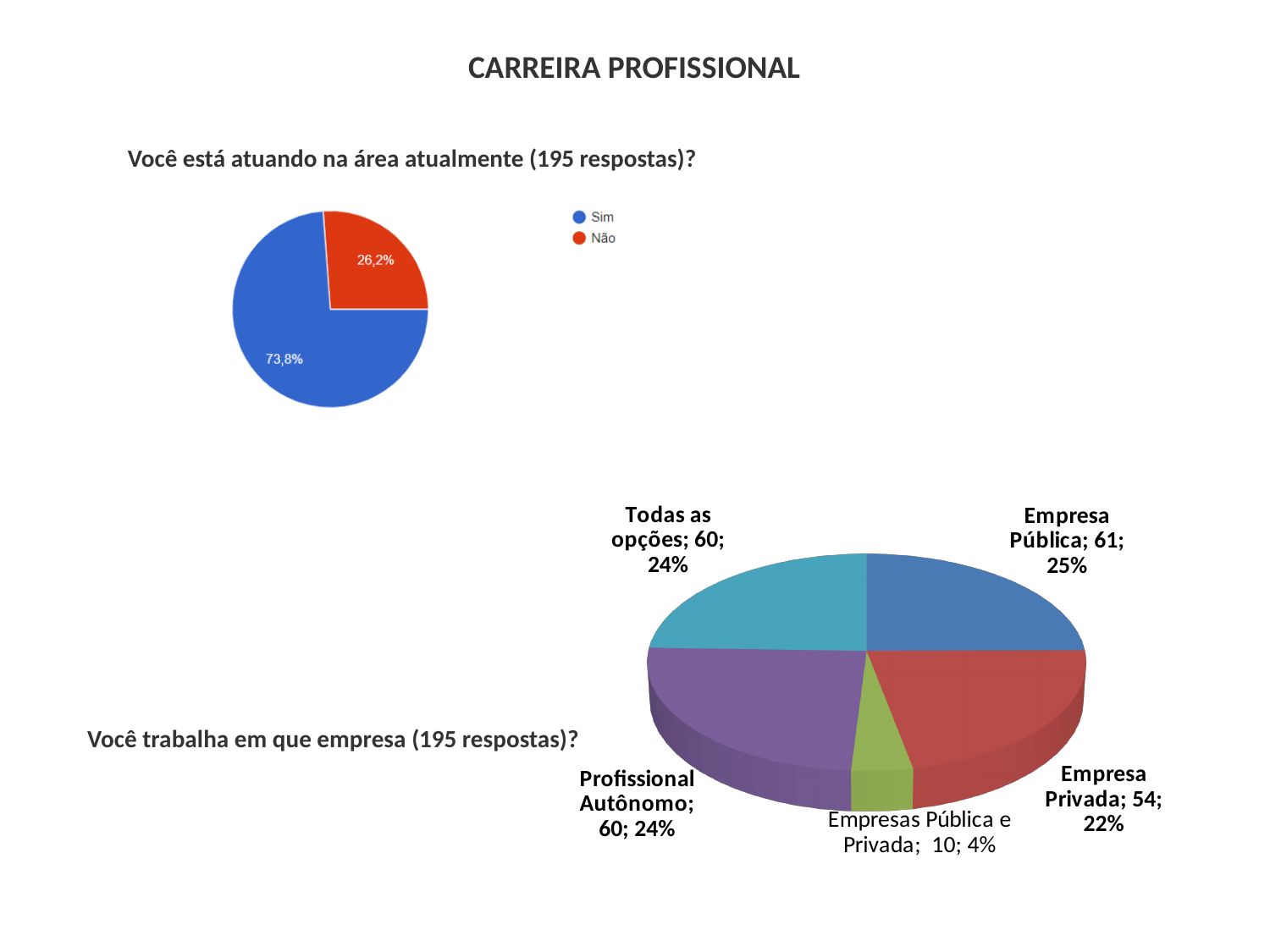
In the bottom pie chart (Você trabalha em que empresa), what percentage of respondents are Profissional Autônomo? 24% In the top pie chart (Você está atuando na área atualmente), what percentage of respondents answered Não? 26,2% In the top pie chart (Você está atuando na área atualmente), how many entries does the legend list? 2 In the bottom pie chart (Você trabalha em que empresa), which category has the largest number of respondents? Empresa Pública In the bottom pie chart (Você trabalha em que empresa), how many categories are shown? 5 In the top pie chart (Você está atuando na área atualmente), what percentage of respondents answered Sim? 73,8% In the bottom pie chart (Você trabalha em que empresa), which category has the smallest number of respondents? Empresas Pública e Privada In the bottom pie chart (Você trabalha em que empresa), what share of the pie does Empresa Privada represent? 22% In the bottom pie chart (Você trabalha em que empresa), what is the difference in respondents between Empresa Pública and Empresa Privada? 7 In the top pie chart (Você está atuando na área atualmente), which slice is larger, Sim or Não? Sim In the bottom pie chart (Você trabalha em que empresa), how many respondents work at Empresa Pública? 61 What kind of chart is used for the question Você trabalha em que empresa? Pie chart